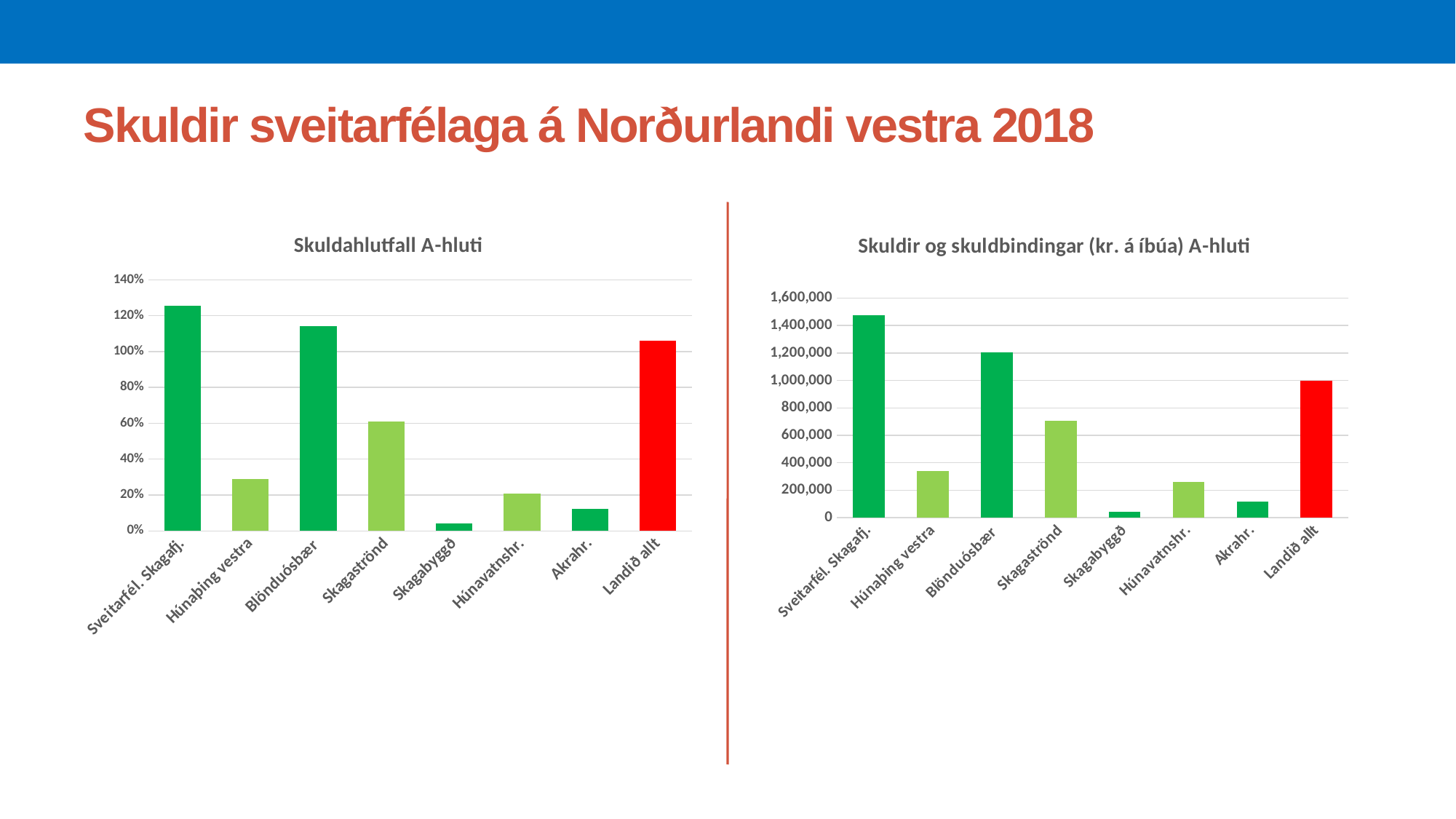
In the chart titled "Skuldahlutfall A-hluti", which is larger, the value for Blönduósbær or the value for Landið allt? Blönduósbær In the chart titled "Skuldir og skuldbindingar (kr. á íbúa) A-hluti", which category has the lowest value? Skagabyggð In the chart titled "Skuldir og skuldbindingar (kr. á íbúa) A-hluti", what colour is the bar for Landið allt? red In the chart titled "Skuldahlutfall A-hluti", which category has the highest value? Sveitarfél. Skagafj. In the chart titled "Skuldir og skuldbindingar (kr. á íbúa) A-hluti", which category has the highest value? Sveitarfél. Skagafj. What kind of chart is the chart titled "Skuldir og skuldbindingar (kr. á íbúa) A-hluti"? bar chart In the chart titled "Skuldahlutfall A-hluti", is the value for Húnaþing vestra greater or less than 40%? less In the chart titled "Skuldahlutfall A-hluti", is the value for Skagaströnd greater or less than 40%? greater How many categories are shown in the chart titled "Skuldahlutfall A-hluti"? 8 In the chart titled "Skuldir og skuldbindingar (kr. á íbúa) A-hluti", which is larger, the value for Skagaströnd or the value for Húnavatnshr.? Skagaströnd In the chart titled "Skuldahlutfall A-hluti", which category has the lowest value? Skagabyggð In the chart titled "Skuldir og skuldbindingar (kr. á íbúa) A-hluti", is the value for Blönduósbær greater or less than 1,000,000? greater